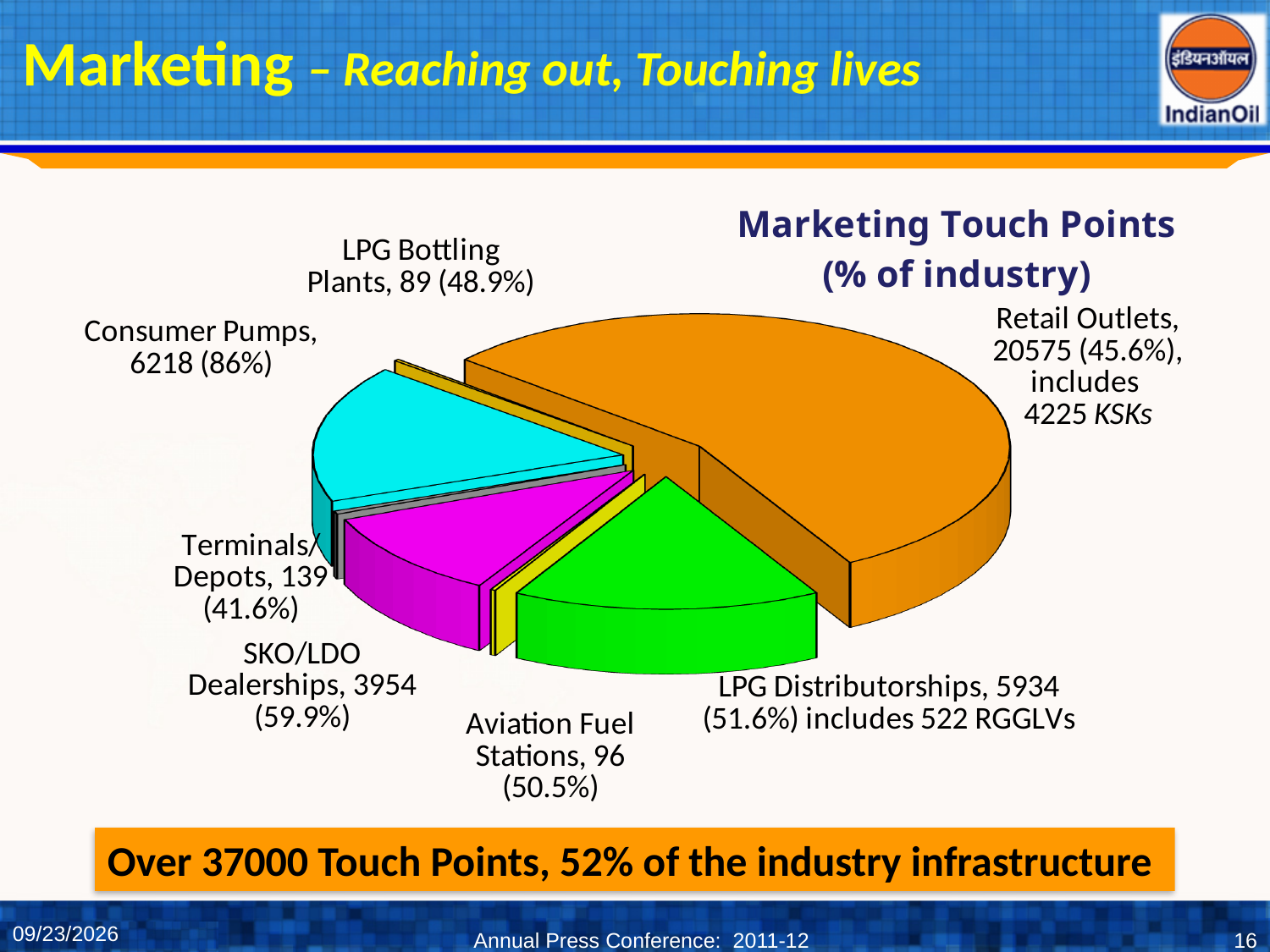
How many Retail Outlets are shown in the chart? 20575 What kind of chart is shown on the slide? pie chart Which has more touch points, SKO/LDO Dealerships or Terminals/Depots? SKO/LDO Dealerships What is the title of the chart? Marketing Touch Points (% of industry) How many Aviation Fuel Stations are shown in the chart? 96 Which category has the largest number of touch points? Retail Outlets What percentage of industry is shown for Consumer Pumps? 86% Which category has the smallest number of touch points? LPG Bottling Plants What is the difference between the number of Consumer Pumps and the number of LPG Distributorships? 284 How many categories (slices) does the pie chart have? 7 What percentage of industry is shown for Terminals/Depots? 41.6% What is the number of LPG Distributorships shown in the chart? 5934